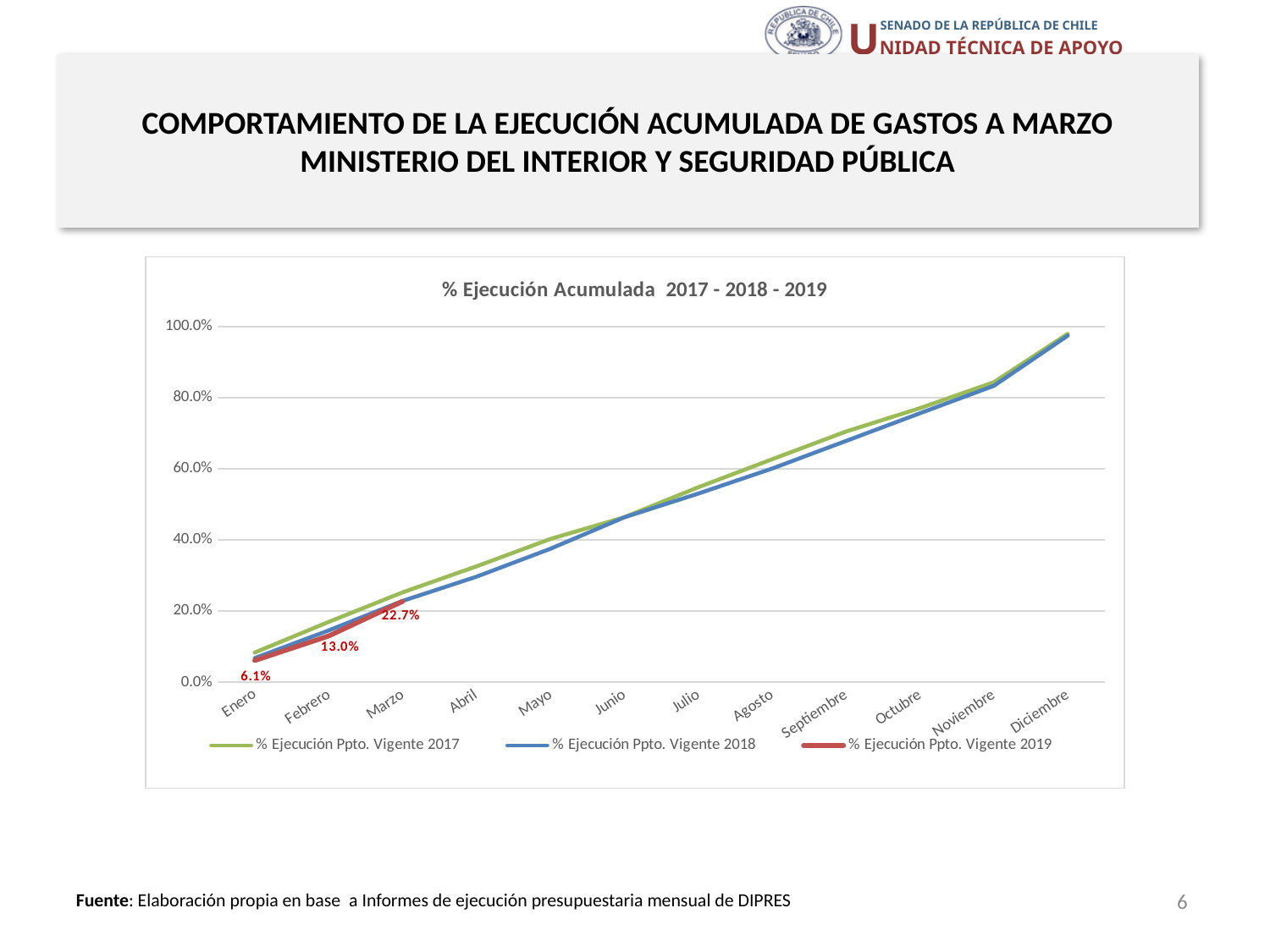
By how many percentage points does the 2019 series rise from Febrero to Marzo? 9.7% How many series does the legend list? 3 What is the title of the chart? % Ejecución Acumulada 2017 - 2018 - 2019 Is the value for Diciembre in the % Ejecución Ppto. Vigente 2018 series greater or less than 80.0%? greater By how many percentage points does the 2019 series rise from Enero to Febrero? 6.9% How many months are shown on the x axis? 12 Do the values of the % Ejecución Ppto. Vigente 2017 series rise or fall from Enero to Diciembre? Rise What is the value for Marzo in the % Ejecución Ppto. Vigente 2019 series? 22.7% What is the value for Enero in the % Ejecución Ppto. Vigente 2019 series? 6.1% What kind of chart is shown on the slide? Line chart What is the value for Febrero in the % Ejecución Ppto. Vigente 2019 series? 13.0% Which month has the highest value in the % Ejecución Ppto. Vigente 2019 series? Marzo